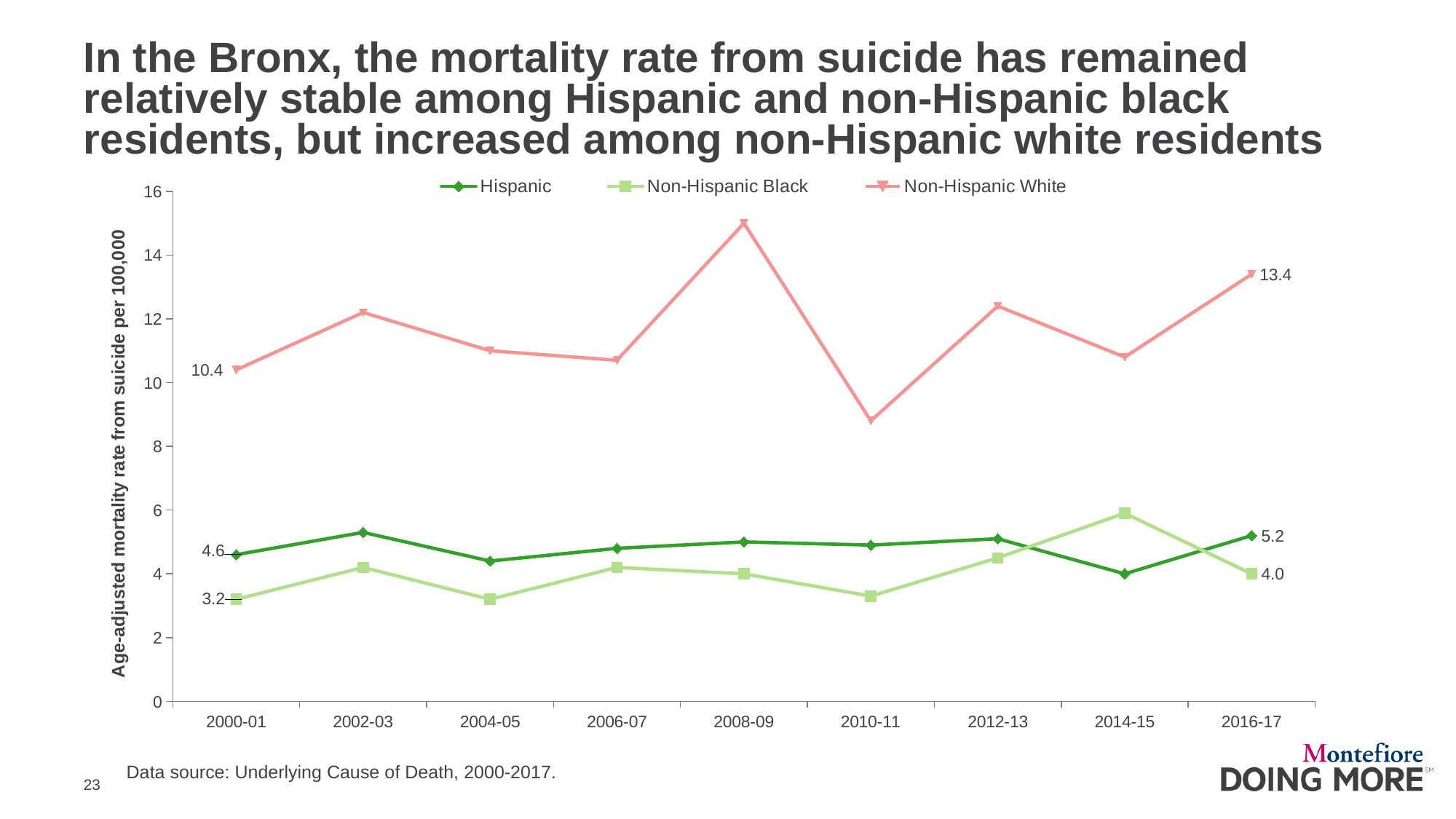
In which period does the Non-Hispanic White suicide mortality rate reach its highest point? 2008-09 What is the age-adjusted suicide mortality rate for Non-Hispanic White residents in 2000-01? 10.4 Is the Non-Hispanic White suicide mortality rate in 2010-11 greater or less than 10? less What is the difference between the Hispanic suicide mortality rate in 2016-17 and in 2000-01? 0.6 How many time periods are shown on the x axis of the chart? 9 How many series does the chart's legend list? 3 What is the age-adjusted suicide mortality rate for Non-Hispanic Black residents in 2016-17? 4.0 In 2016-17, which group has the higher suicide mortality rate: Hispanic or Non-Hispanic Black? Hispanic What is the age-adjusted suicide mortality rate for Non-Hispanic White residents in 2016-17? 13.4 By how much did the Non-Hispanic White suicide mortality rate increase from 2000-01 to 2016-17? 3.0 Is the Non-Hispanic White suicide mortality rate in 2008-09 greater or less than 14? greater What is the age-adjusted suicide mortality rate for Hispanic residents in 2000-01? 4.6